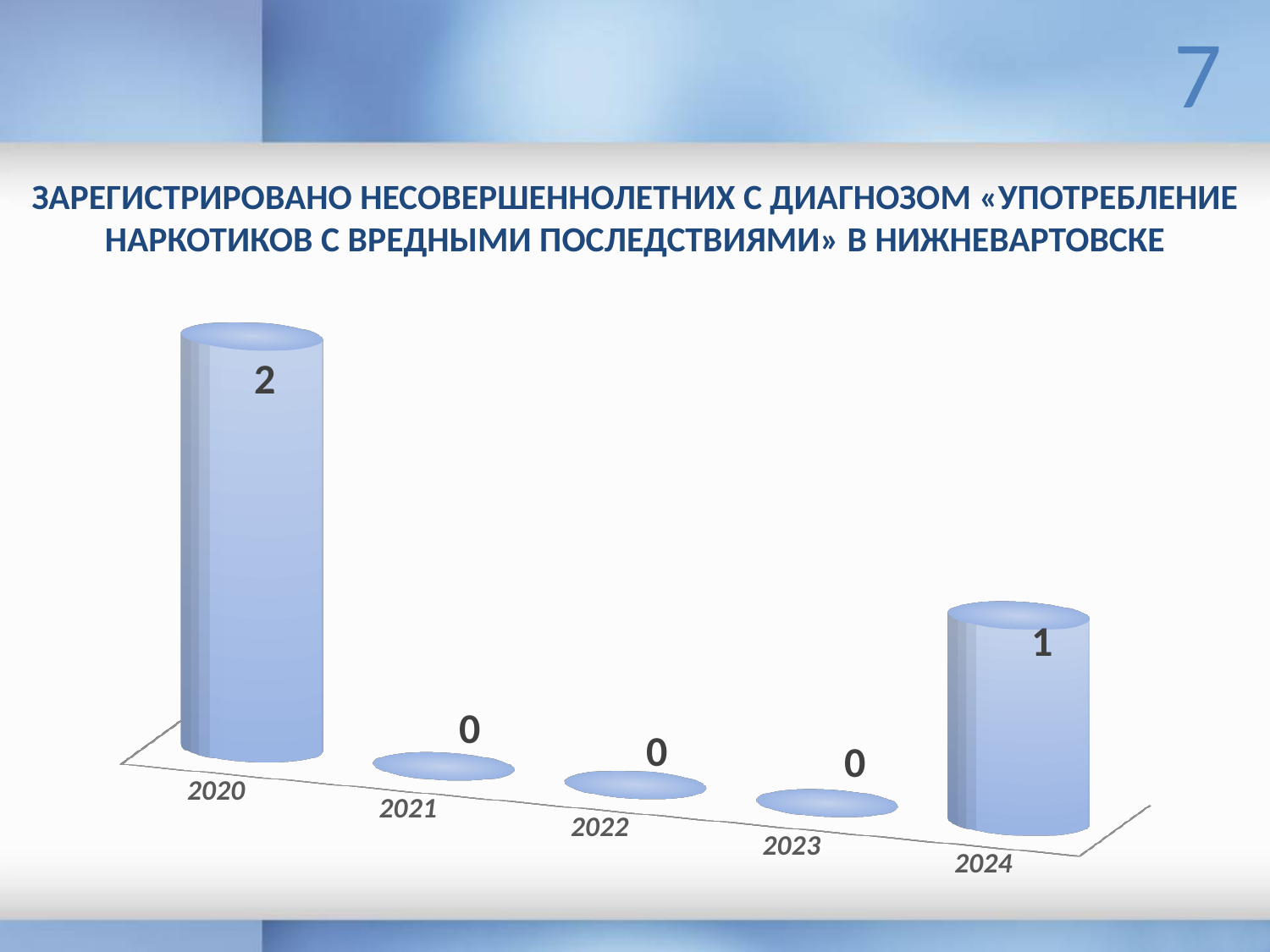
What is the value for 2020? 2 How many years are shown on the x axis? 5 What is the first year shown on the x axis? 2020 What kind of chart is shown on the slide? bar chart Which year has the highest value? 2020 What is the total of the values across all five years? 3 What is the value for 2024? 1 What is the difference between the values for 2020 and 2024? 1 Which is larger, the value for 2020 or the value for 2024? 2020 Does the value rise or fall from 2020 to 2021? fall What is the value for 2022? 0 How many years have a value of 0? 3